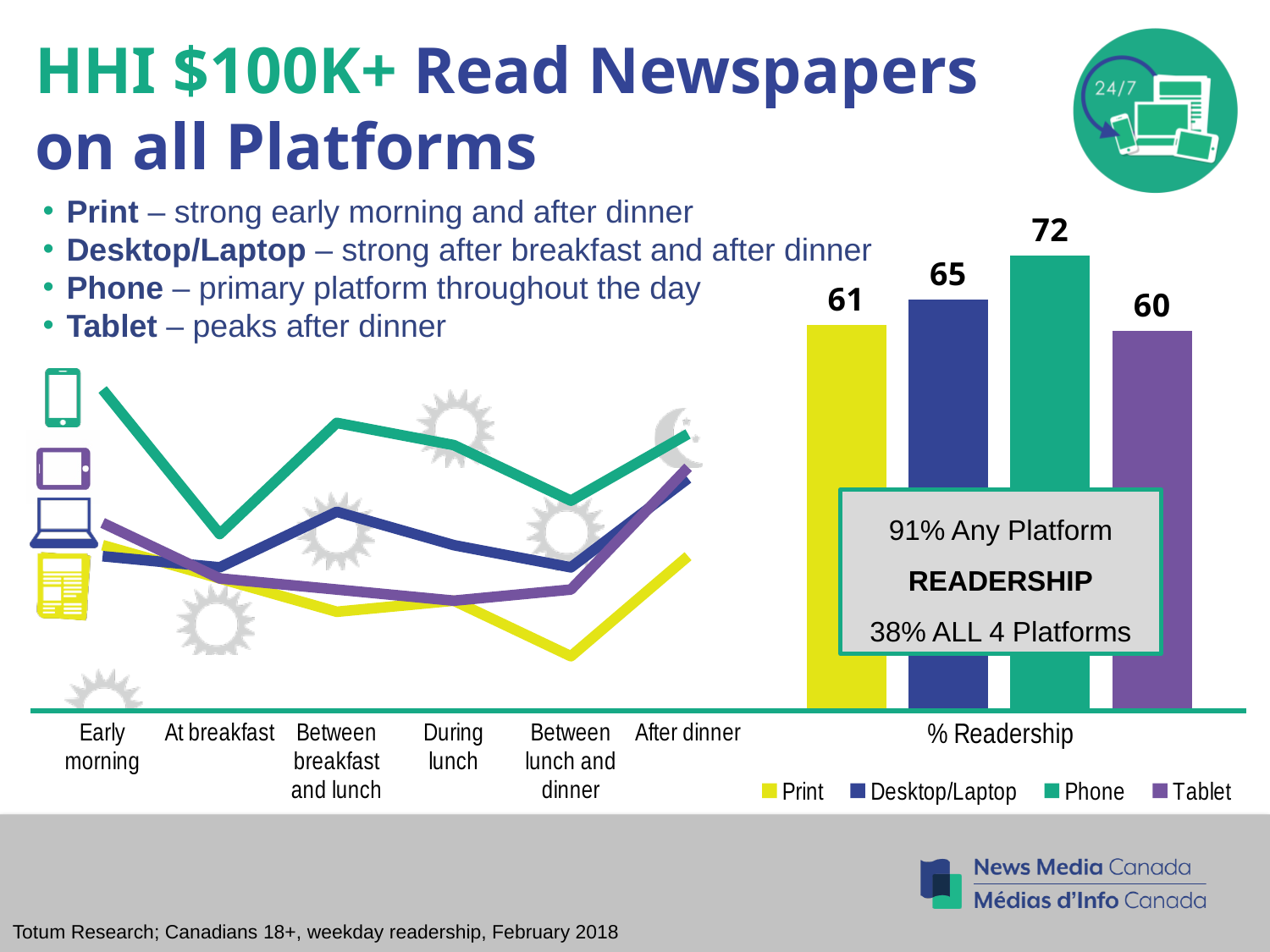
In the bar chart on the right, which platform has the lowest % Readership? Tablet In the bar chart on the right, what is the % Readership value for Phone? 72 How many bars are shown in the bar chart on the right? 4 In the bar chart on the right, which platform has the highest % Readership? Phone In the line chart on the left, which platform has the highest line at Early morning? Phone How many time-of-day categories are shown on the x axis of the line chart on the left? 6 In the bar chart on the right, which is larger, the value for Print or the value for Tablet? Print What kind of chart is the chart on the left of the slide? Line chart In the bar chart on the right, what is the difference between the Phone and Print values? 11 How many series does the legend below the charts list? 4 In the line chart on the left, does the Print line rise or fall from Between lunch and dinner to After dinner? Rise In the bar chart on the right, what is the % Readership value for Desktop/Laptop? 65